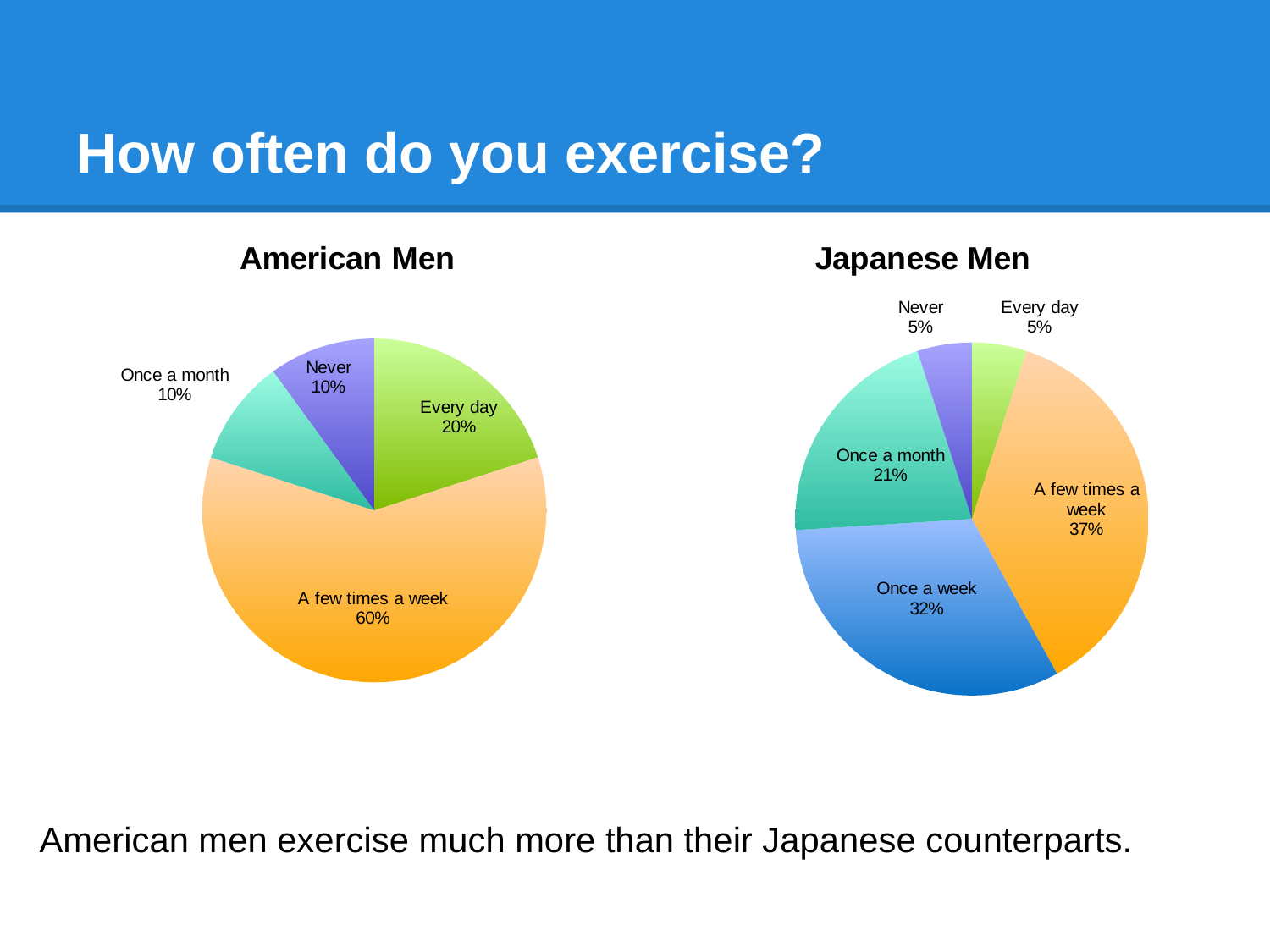
In the Japanese Men chart, what share of respondents exercise once a week? 32% In the American Men chart, what share of respondents exercise a few times a week? 60% In the American Men chart, how many categories are shown? 4 In the Japanese Men chart, how many categories are shown? 5 In the Japanese Men chart, which category has the largest slice? A few times a week Which is larger: the 'Once a month' share in the American Men chart or in the Japanese Men chart? Japanese Men What is the title of the chart on the right side of the slide? Japanese Men In the Japanese Men chart, what share of respondents exercise every day? 5% In the American Men chart, what is the difference between the 'Every day' share and the 'Never' share? 10% What is the difference between the 'A few times a week' share in the American Men chart and in the Japanese Men chart? 23% In the American Men chart, which category has the largest slice? A few times a week What kind of chart is the American Men chart? Pie chart